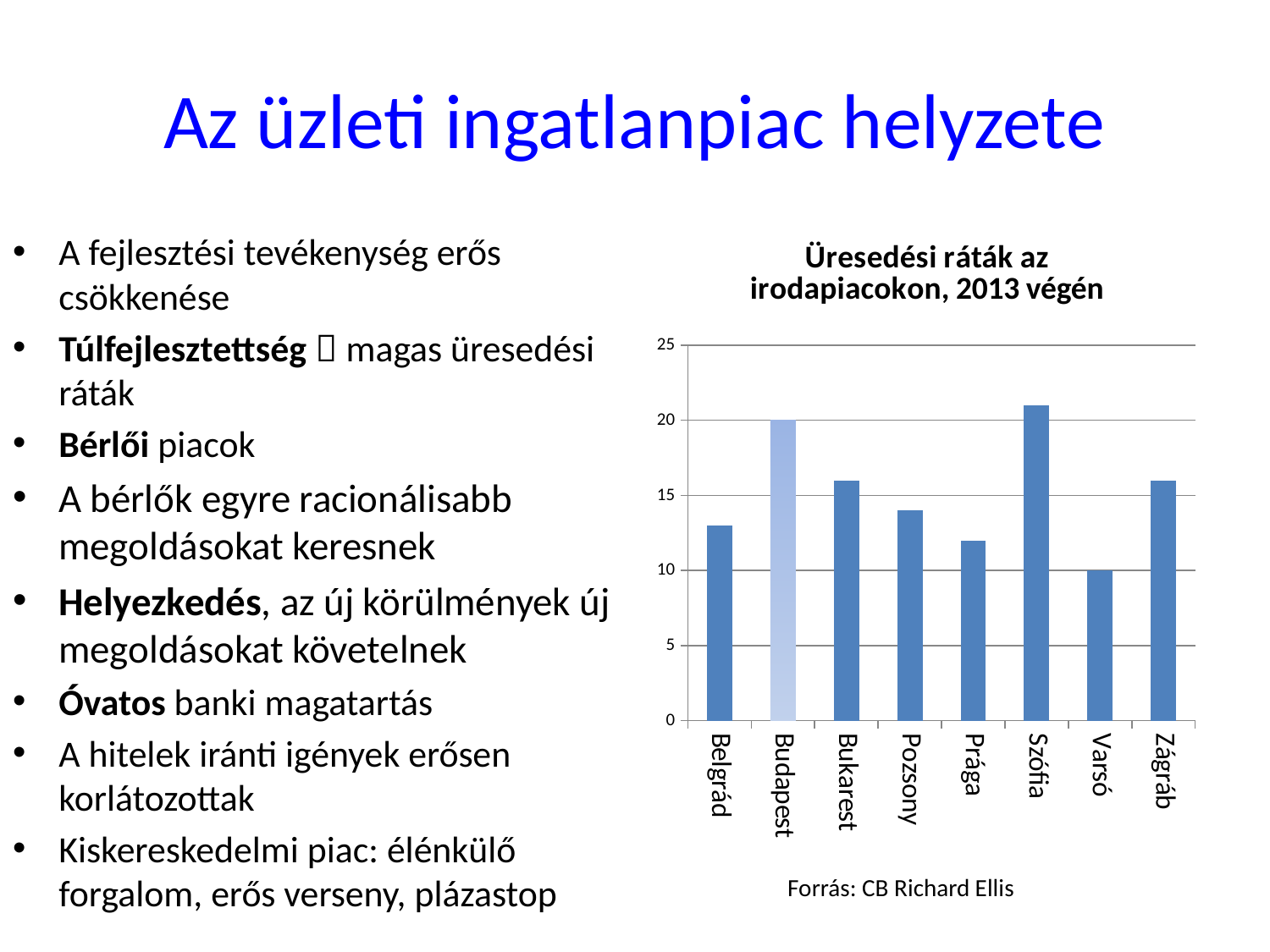
Is the value for Szófia greater or less than 20? greater Is the value for Belgrád greater or less than 15? less What is the vacancy rate value shown for Budapest? 20 What is the vacancy rate value shown for Varsó? 10 Is the value for Bukarest greater or less than 15? greater What is the title of the chart? Üresedési ráták az irodapiacokon, 2013 végén How many cities are shown on the x axis of the chart? 8 Which city has the lowest vacancy rate in the chart? Varsó Which has the larger vacancy rate, Budapest or Pozsony? Budapest What kind of chart is shown on the slide? bar chart Which city has the highest vacancy rate in the chart? Szófia Which city's bar is drawn in a lighter colour than the others? Budapest